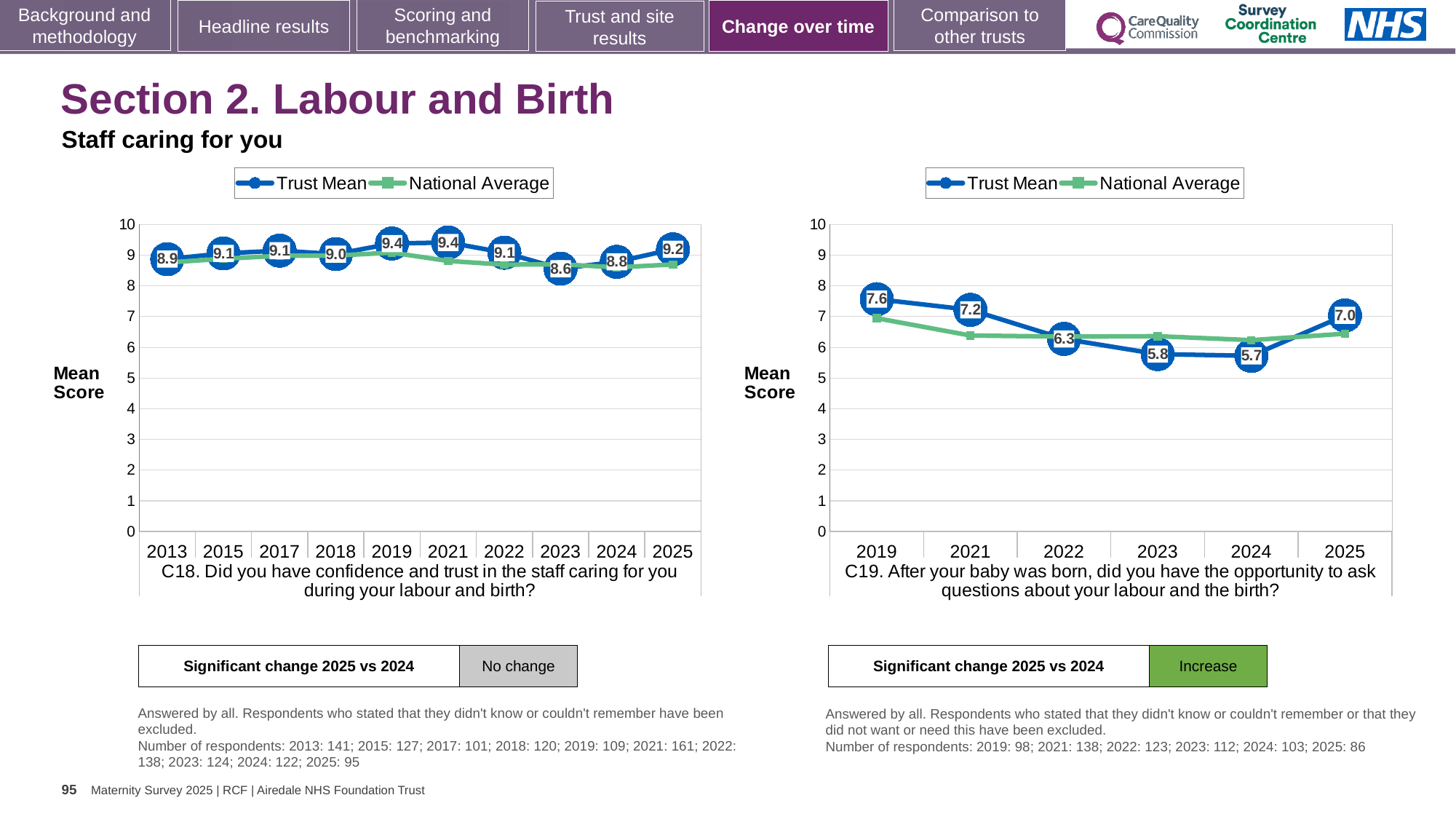
In the C19 chart on the right, is the National Average value for 2021 greater or less than 7? less In the C19 chart on the right, which year has the lowest Trust Mean score? 2024 In the C18 chart on the left, is the Trust Mean score higher in 2025 or in 2024? 2025 In the C18 chart on the left, which year has the lowest Trust Mean score? 2023 What kind of chart is the C18 chart on the left? Line chart In the C19 chart on the right, which year has the highest Trust Mean score? 2019 How many years are plotted on the x axis of the C18 chart on the left? 10 In the C18 chart on the left, what is the Trust Mean score for 2023? 8.6 In the C19 chart on the right, does the Trust Mean score rise or fall from 2019 to 2024? Fall In the C19 chart on the right, what is the Trust Mean score for 2025? 7.0 In the C19 chart on the right, what is the difference between the Trust Mean scores for 2019 and 2024? 1.9 How many series does the legend of the C19 chart on the right list? 2